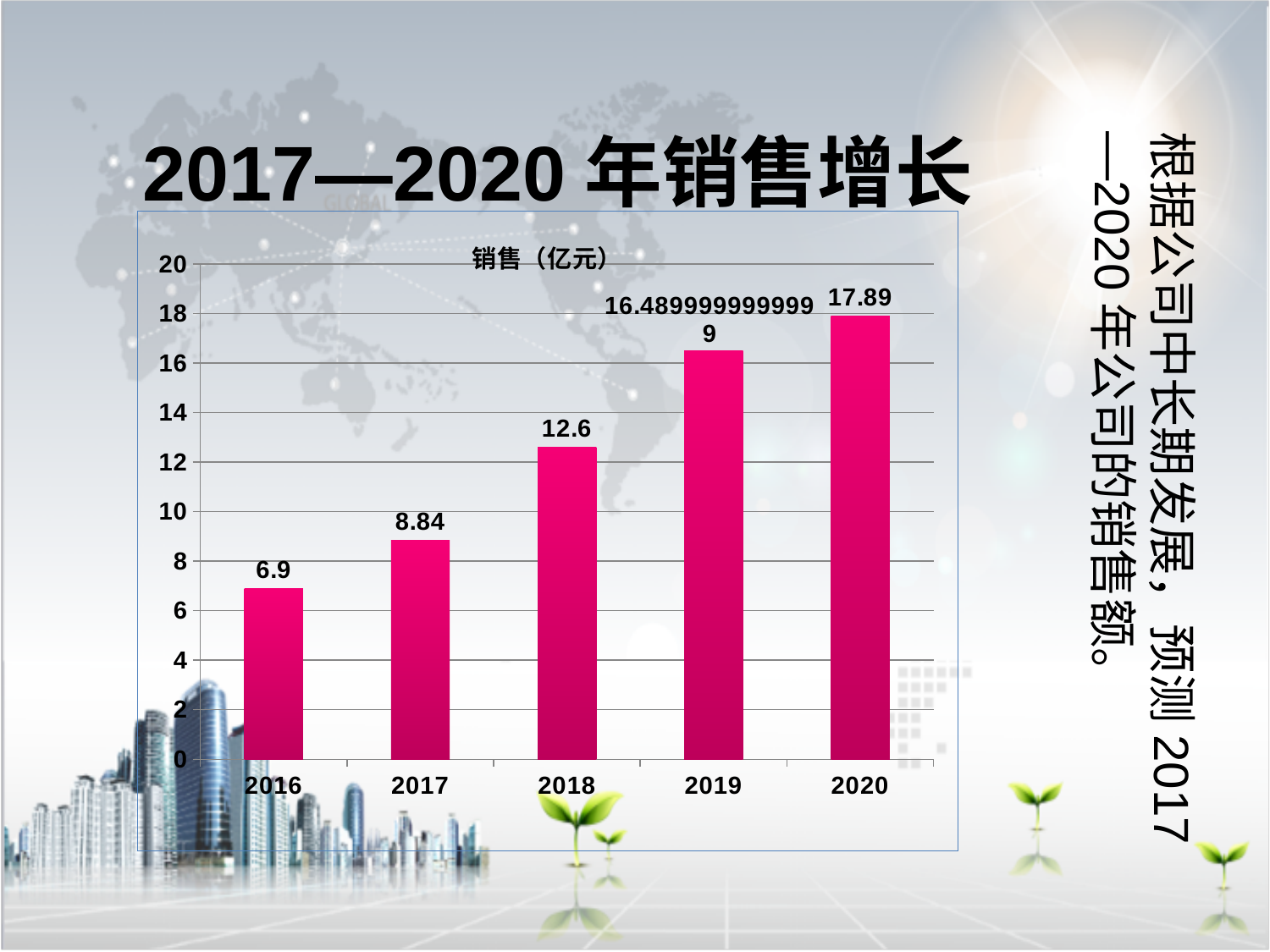
What is the value for 2020? 17.89 What kind of chart is this? bar chart Do the values rise or fall from 2016 to 2020? rise What is the value for 2018? 12.6 Is the value for 2019 greater or less than 16? greater What is the value for 2016? 6.9 Which is larger, the value for 2017 or the value for 2018? 2018 Which year has the highest value? 2020 What is the difference between the values for 2018 and 2016? 5.7 Which year has the lowest value? 2016 What is the value for 2017? 8.84 How many years are shown on the x axis? 5